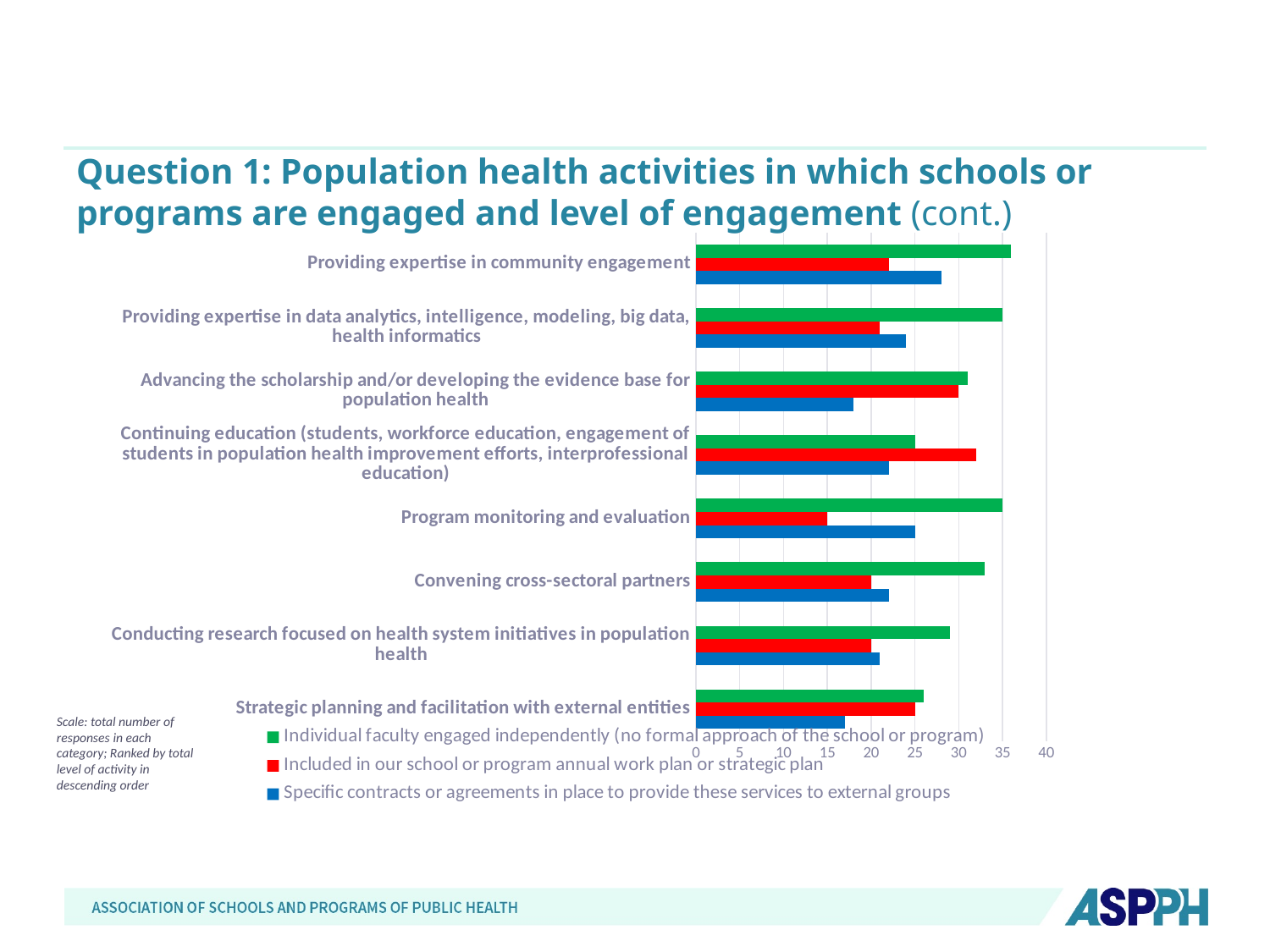
How many population health activity categories are plotted on the chart? 8 Is the value for 'Specific contracts or agreements in place to provide these services to external groups' for 'Providing expertise in community engagement' greater or less than 25? greater For 'Program monitoring and evaluation', which series has the larger value: 'Individual faculty engaged independently' or 'Included in our school or program annual work plan or strategic plan'? Individual faculty engaged independently Which category has the lowest value for 'Included in our school or program annual work plan or strategic plan'? Program monitoring and evaluation What kind of chart is shown on the slide? bar chart Is the value for 'Specific contracts or agreements in place to provide these services to external groups' for 'Advancing the scholarship and/or developing the evidence base for population health' greater or less than 20? less For 'Continuing education', which series has the larger value: 'Individual faculty engaged independently' or 'Included in our school or program annual work plan or strategic plan'? Included in our school or program annual work plan or strategic plan Is the value for 'Included in our school or program annual work plan or strategic plan' for 'Continuing education' greater or less than 30? greater How many series does the chart's legend list? 3 Which colour represents 'Included in our school or program annual work plan or strategic plan' in the legend? red